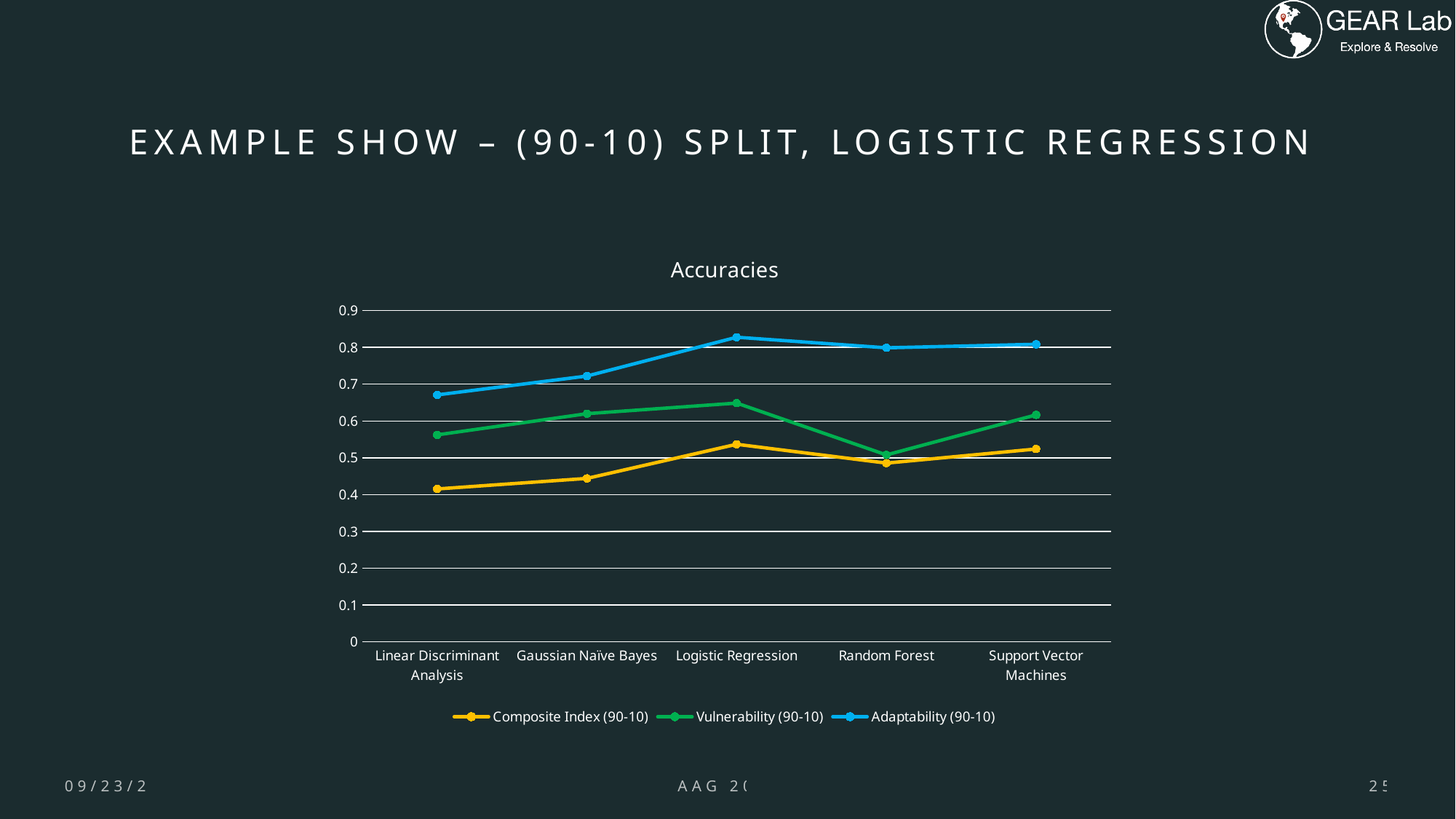
For which classifier is the Vulnerability (90-10) accuracy lowest? Random Forest For which classifier is the Composite Index (90-10) accuracy lowest? Linear Discriminant Analysis For Gaussian Naïve Bayes, which series has the larger accuracy: Adaptability (90-10) or Vulnerability (90-10)? Adaptability (90-10) Is the Adaptability (90-10) value for Logistic Regression greater or less than 0.8? greater For which classifier is the Vulnerability (90-10) accuracy highest? Logistic Regression Is the Vulnerability (90-10) value for Random Forest greater or less than 0.6? less How many series does the legend of the Accuracies chart list? 3 What kind of chart is shown on the slide? Line chart What is the title of the chart on the slide? Accuracies For which classifier is the Adaptability (90-10) accuracy lowest? Linear Discriminant Analysis Is the Adaptability (90-10) value for Linear Discriminant Analysis greater or less than 0.7? less How many classifier categories are shown on the x axis of the Accuracies chart? 5